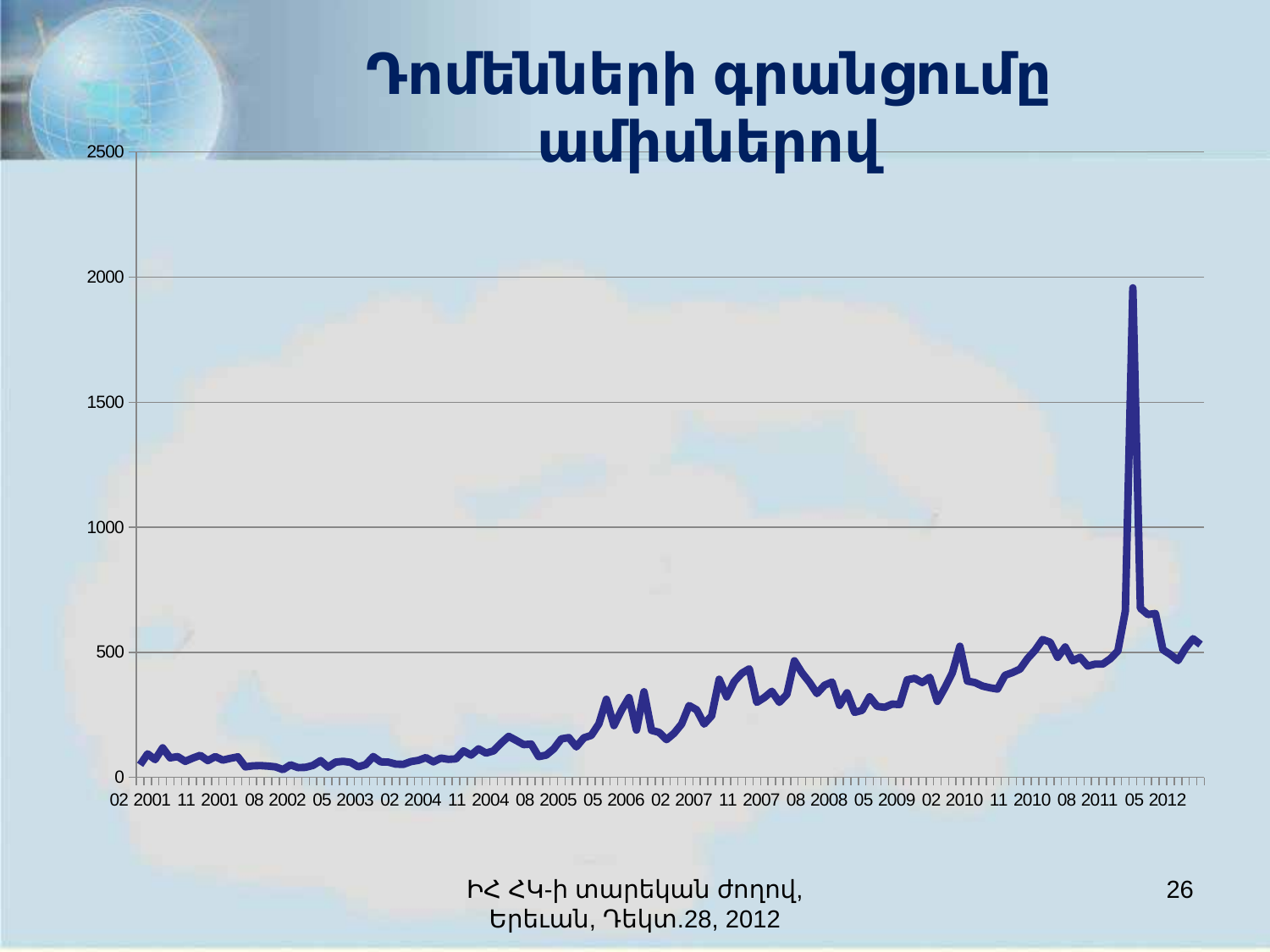
Is the peak value of the line greater or less than 1500? greater Is the value at 02 2001 greater or less than 500? less What is the title of the chart? Դոմենների գրանցումը ամիսներով Is the value at 11 2004 greater or less than 500? less Does the highest point of the line occur before or after the 08 2011 label? after What kind of chart is shown on the slide? line chart How many date labels are printed along the x axis? 16 Overall, do the values rise or fall from 02 2001 to 2012? rise What is the highest value shown on the vertical axis? 2500 Which is larger, the value at 02 2001 or the value at 11 2007? 11 2007